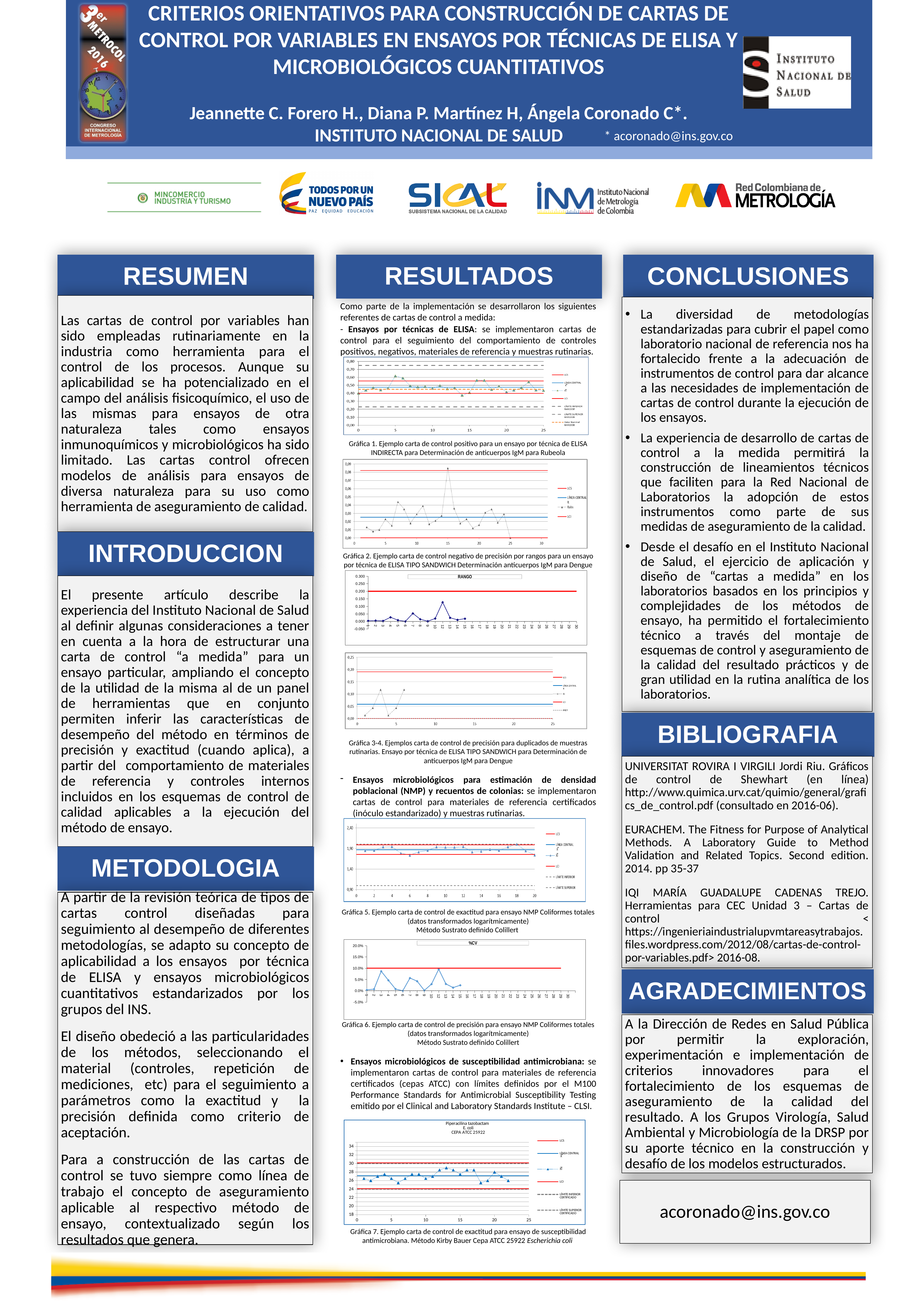
How many entries does the legend of Gráfica 7 (Piperacilina tazobactam E. coli CEPA ATCC 25922) list? 6 What kind of chart is Gráfica 7 (Piperacilina tazobactam E. coli CEPA ATCC 25922)? line chart How many entries does the legend of Gráfica 2 (carta de control negativo, ELISA TIPO SANDWICH Dengue) list? 4 In Gráfica 7 (Piperacilina tazobactam E. coli CEPA ATCC 25922), is the highest plotted point of the X̄ series greater or less than 32? less In Gráfica 2 (carta de control negativo, ELISA TIPO SANDWICH Dengue), is the highest plotted point of the Rabs series greater or less than 0.06? greater In Gráfica 5 (carta de control de exactitud NMP Coliformes totales), are the plotted X̄ values greater or less than 1.40? greater What is the title printed above the chart labelled Gráfica 6 (the chart with the y axis from -5.0% to 20.0%)? %CV What is the title printed above the chart labelled Gráfica 3 (the chart with the y axis from -0.050 to 0.300)? RANGO What kind of chart is Gráfica 6 (%CV)? line chart